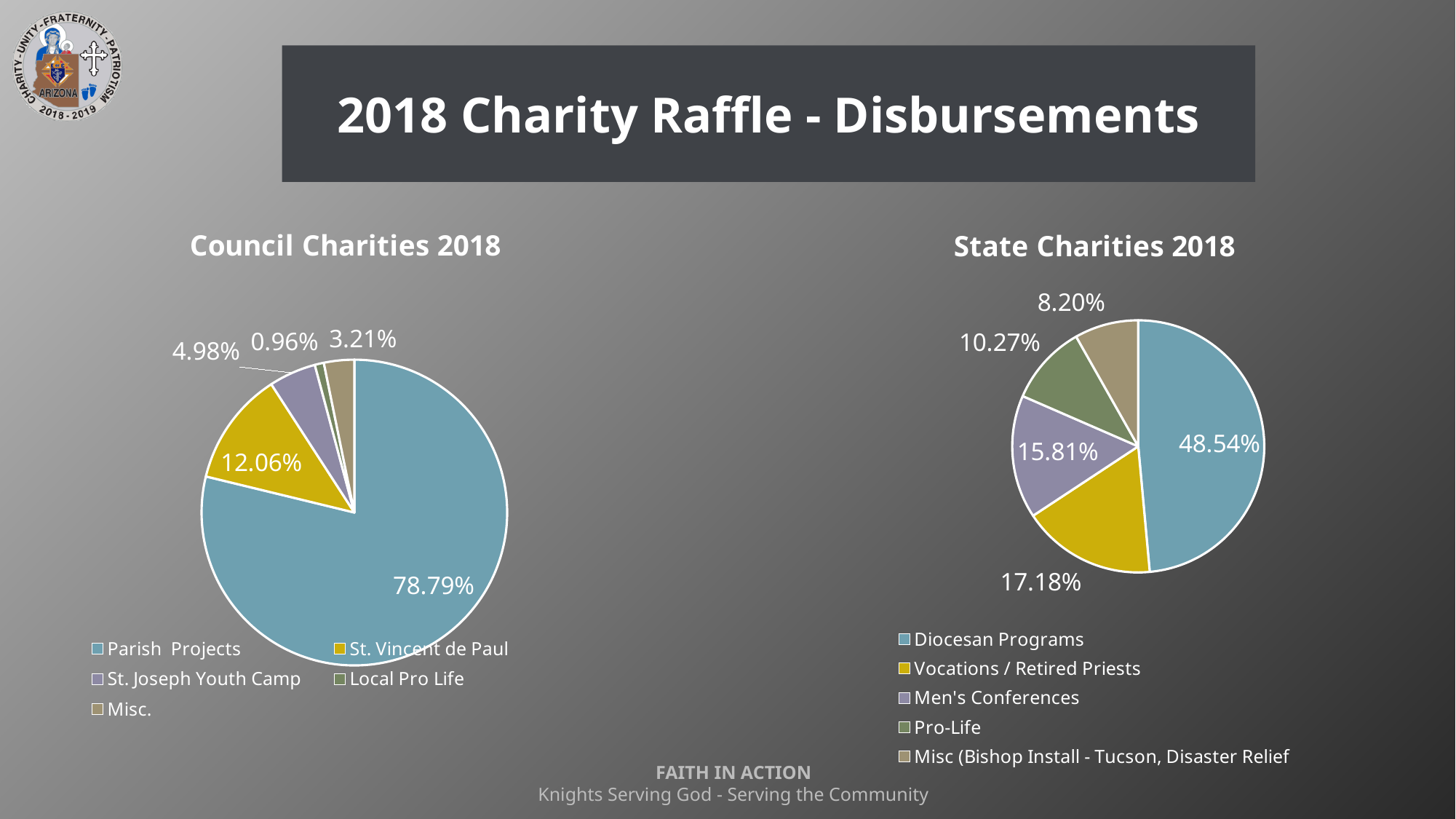
In the State Charities 2018 chart, what is the difference between the Vocations / Retired Priests share and the Pro-Life share? 6.91% In the State Charities 2018 chart, what share does Men's Conferences have? 15.81% In the Council Charities 2018 chart, which category has the smallest slice? Local Pro Life In the State Charities 2018 chart, which category has the largest slice? Diocesan Programs In the Council Charities 2018 chart, how many categories does the legend list? 5 In the Council Charities 2018 chart, what share does St. Vincent de Paul have? 12.06% What is the title of the chart on the left side of the slide? Council Charities 2018 In the Council Charities 2018 chart, what share does Local Pro Life have? 0.96% What kind of chart is the State Charities 2018 chart? Pie chart In the State Charities 2018 chart, which is larger, Men's Conferences or Pro-Life? Men's Conferences